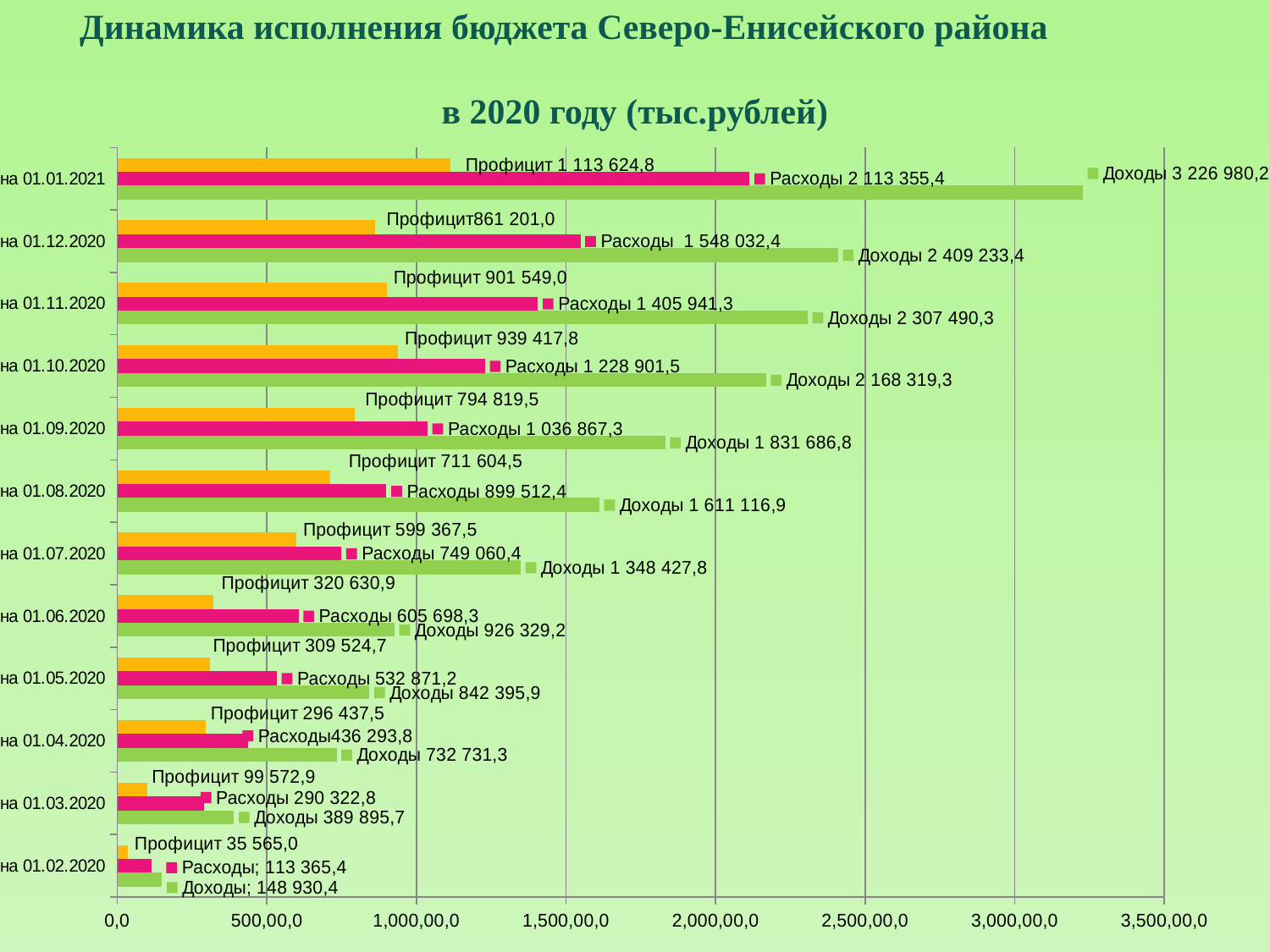
On which date is Профицит the lowest? на 01.02.2020 What is the value of Доходы on 01.05.2020? 842 395,9 Is the value of Доходы on 01.12.2020 greater or less than 2,000,00,0? greater What kind of chart is shown on the slide? bar chart On which date is Доходы the highest? на 01.01.2021 What is the difference between Доходы and Расходы on 01.01.2021? 1 113 624,8 What is the value of Расходы on 01.07.2020? 749 060,4 Which is larger on 01.11.2020: Расходы or Профицит? Расходы Does Доходы rise or fall from 01.02.2020 to 01.01.2021? rise What is the value of Профицит on 01.10.2020? 939 417,8 What is the value of Доходы on 01.01.2021? 3 226 980,2 How many dates (categories) are shown on the chart? 12